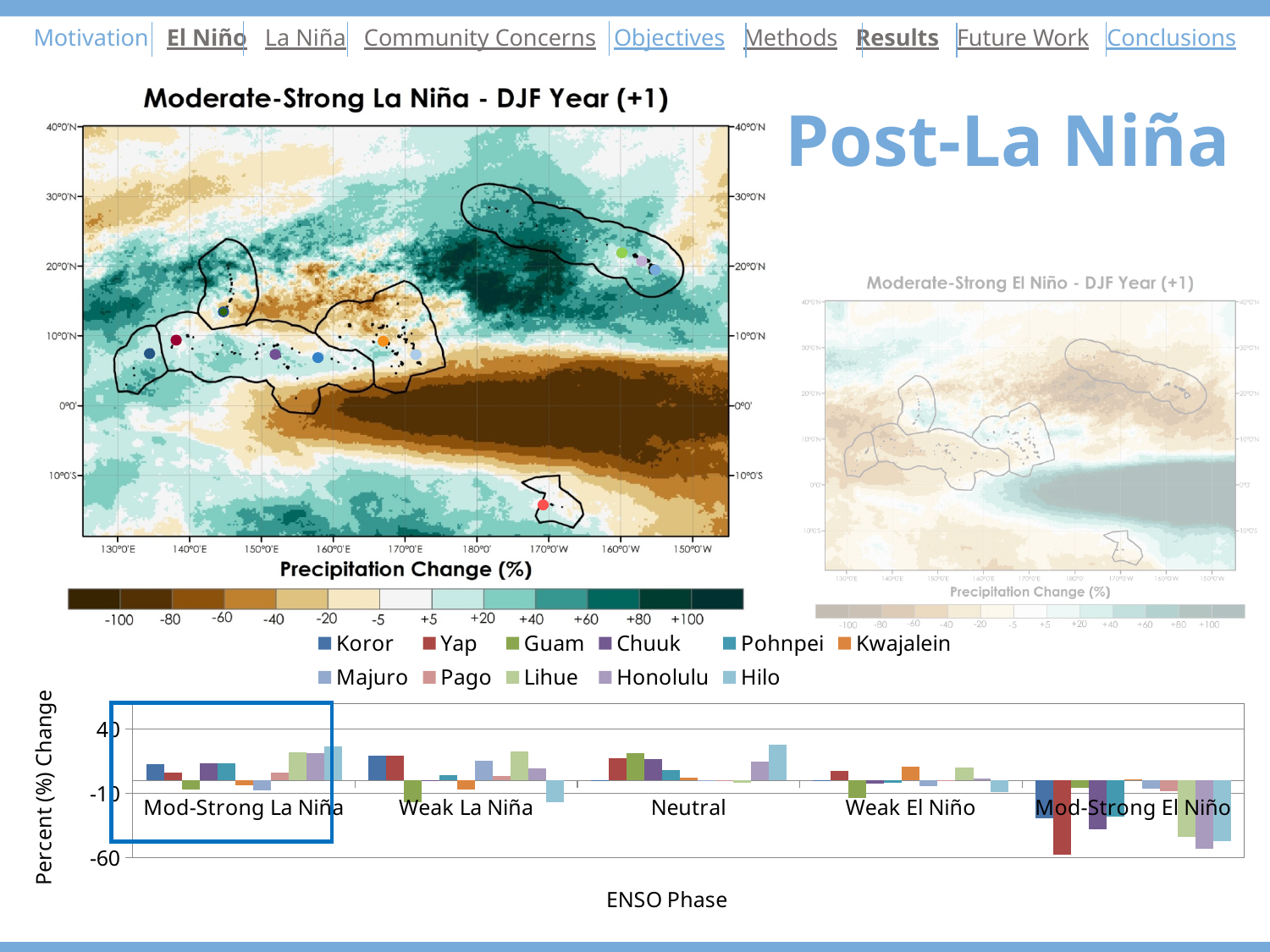
How many series does the legend of the bar chart list? 11 In the bar chart, which series has the lowest value in the Mod-Strong El Niño phase? Yap How many ENSO phase categories are shown on the x axis of the bar chart? 5 What is the title of the x axis of the bar chart? ENSO Phase What is the title of the y axis of the bar chart? Percent (%) Change In the bar chart, is the value for Honolulu in the Mod-Strong El Niño phase greater or less than -10? less In the bar chart, which is lower in the Mod-Strong El Niño phase: Koror or Yap? Yap What kind of chart is shown at the bottom of the slide? bar chart In the bar chart, is the value for Hilo in the Mod-Strong El Niño phase greater or less than -10? less In the bar chart, is the value for Hilo in the Neutral phase greater or less than 40? less